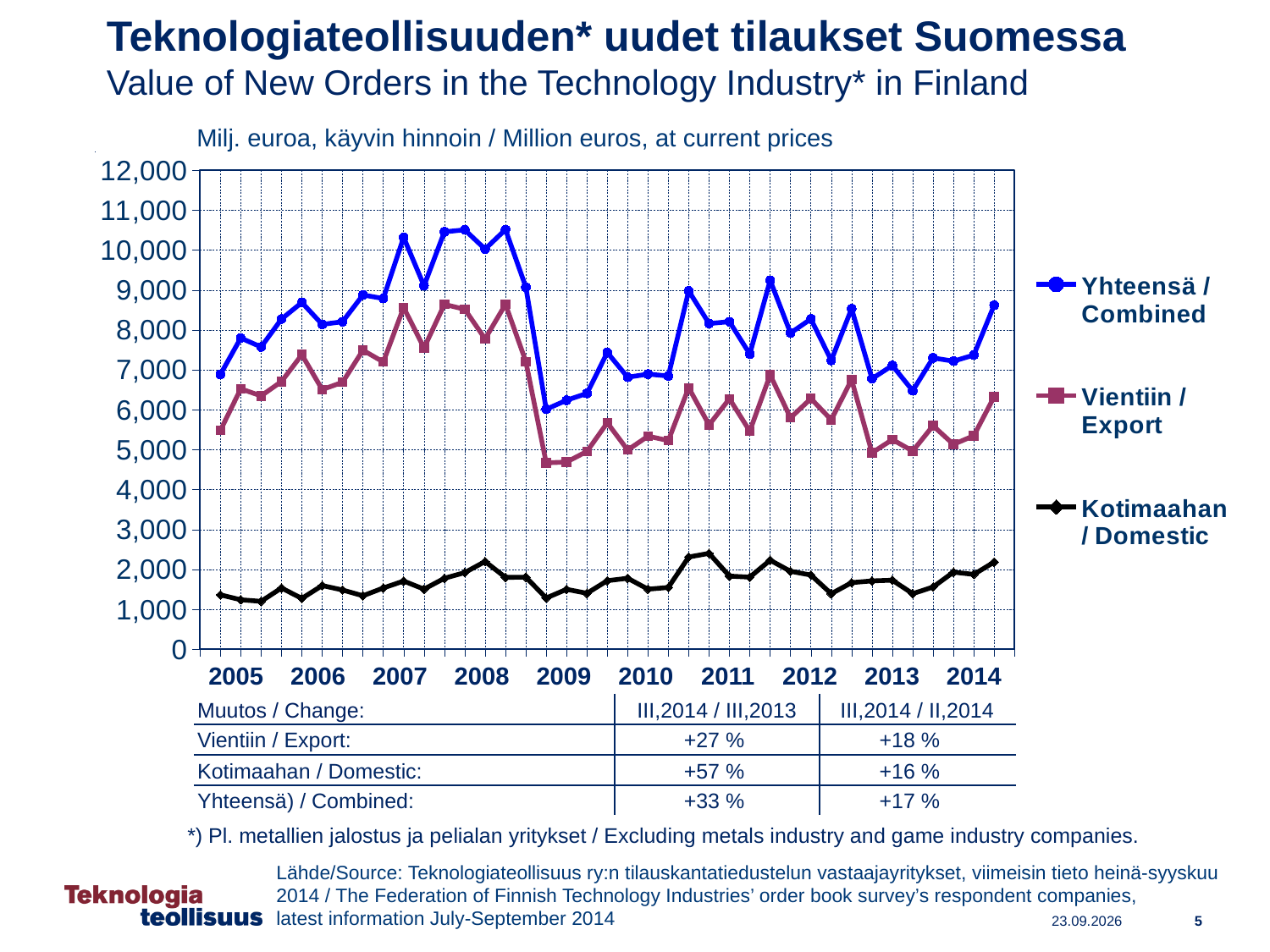
How many years are labelled on the x axis? 10 Which series has the lowest values throughout the chart? Kotimaahan / Domestic Does the Yhteensä / Combined series rise or fall between 2008 and 2009? fall Which series has the highest values throughout the chart? Yhteensä / Combined Is the highest value of the Kotimaahan / Domestic series greater or less than 3,000? less How many series does the legend list? 3 Which is larger in 2014, the Vientiin / Export value or the Kotimaahan / Domestic value? Vientiin / Export What unit is stated above the chart? Milj. euroa, käyvin hinnoin / Million euros, at current prices What colour is the Vientiin / Export line? red What kind of chart is shown on the slide? line chart Is the lowest value of the Vientiin / Export series in 2009 greater or less than 5,000? less Is the peak value of the Yhteensä / Combined series in 2008 greater or less than 10,000? greater